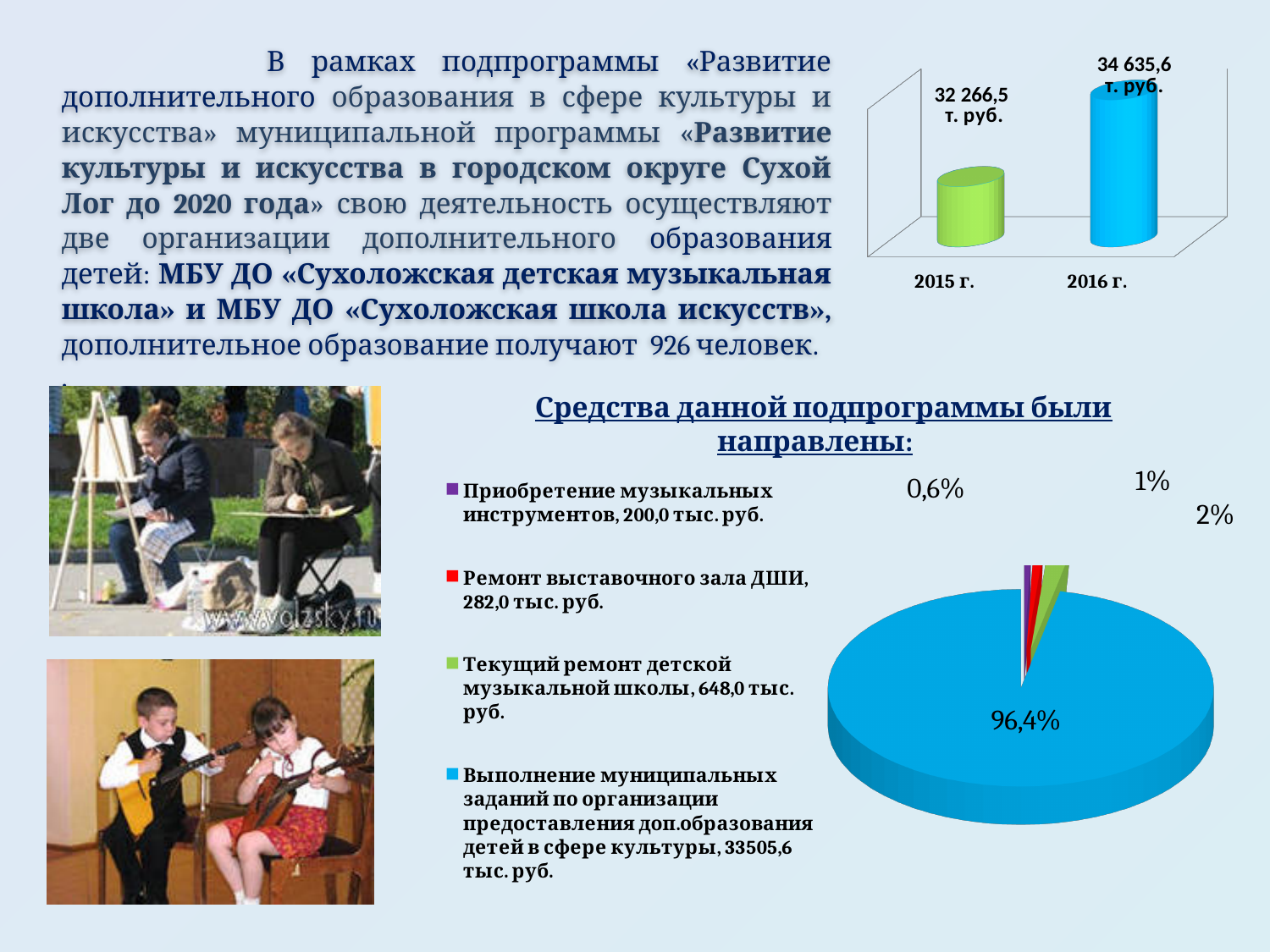
In the bar chart at the top right, by how much does the 2016 г. value exceed the 2015 г. value? 2 369,1 т. руб. In the pie chart at the bottom right, what share is shown for the largest slice? 96,4% What kind of chart is shown at the top right of the slide? Bar chart In the bar chart at the top right, which year has the higher value? 2016 г. In the bar chart at the top right, what is the value for 2016 г.? 34 635,6 т. руб. How many entries does the legend of the pie chart at the bottom right list? 4 What kind of chart is shown at the bottom right of the slide? Pie chart In the pie chart at the bottom right, what colour is the slice for 'Выполнение муниципальных заданий по организации предоставления доп.образования детей в сфере культуры'? Blue In the bar chart at the top right, what is the value for 2015 г.? 32 266,5 т. руб. In the bar chart at the top right, do the values rise or fall from 2015 г. to 2016 г.? Rise In the bar chart at the top right, how many bars are plotted? 2 In the pie chart at the bottom right, what is the smallest percentage shown? 0,6%